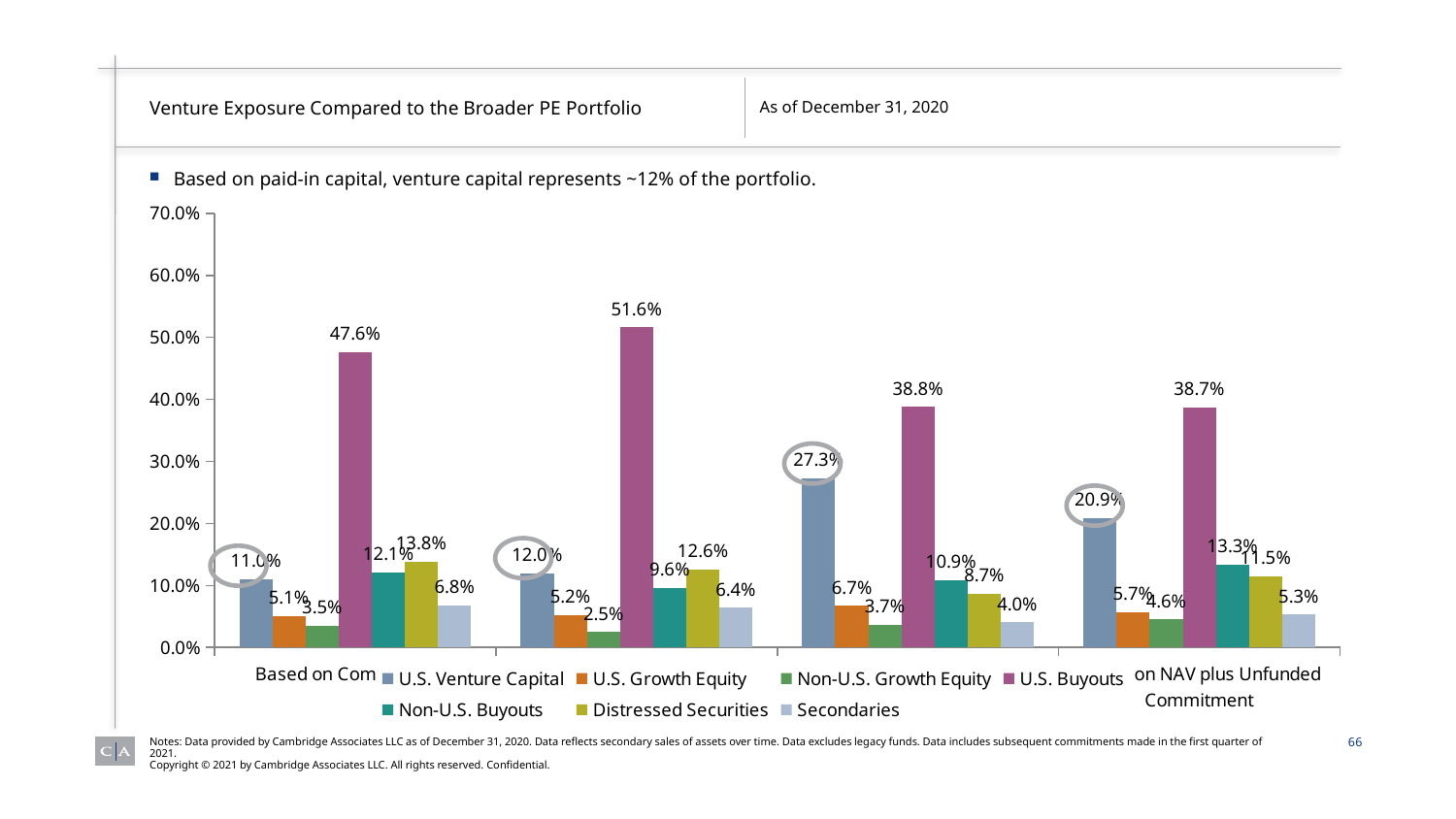
Which series has the highest value in the second group of bars from the left? U.S. Buyouts What is the value for U.S. Buyouts in the leftmost group of bars? 47.6% What is the value for U.S. Venture Capital in the third group of bars from the left? 27.3% What is the difference between the U.S. Buyouts values in the second group (51.6%) and the leftmost group (47.6%)? 4.0% In the rightmost group of bars, which is larger: Distressed Securities or Secondaries? Distressed Securities Which series has the lowest value in the leftmost group of bars? Non-U.S. Growth Equity What is the value for Non-U.S. Buyouts in the rightmost group of bars? 13.3% How many groups of bars are plotted along the x axis? 4 What is the value for Non-U.S. Growth Equity in the second group of bars from the left? 2.5% What type of chart is shown on the slide? bar chart Is the value for U.S. Buyouts in the third group of bars from the left greater or less than 30.0%? greater How many series does the legend list? 7